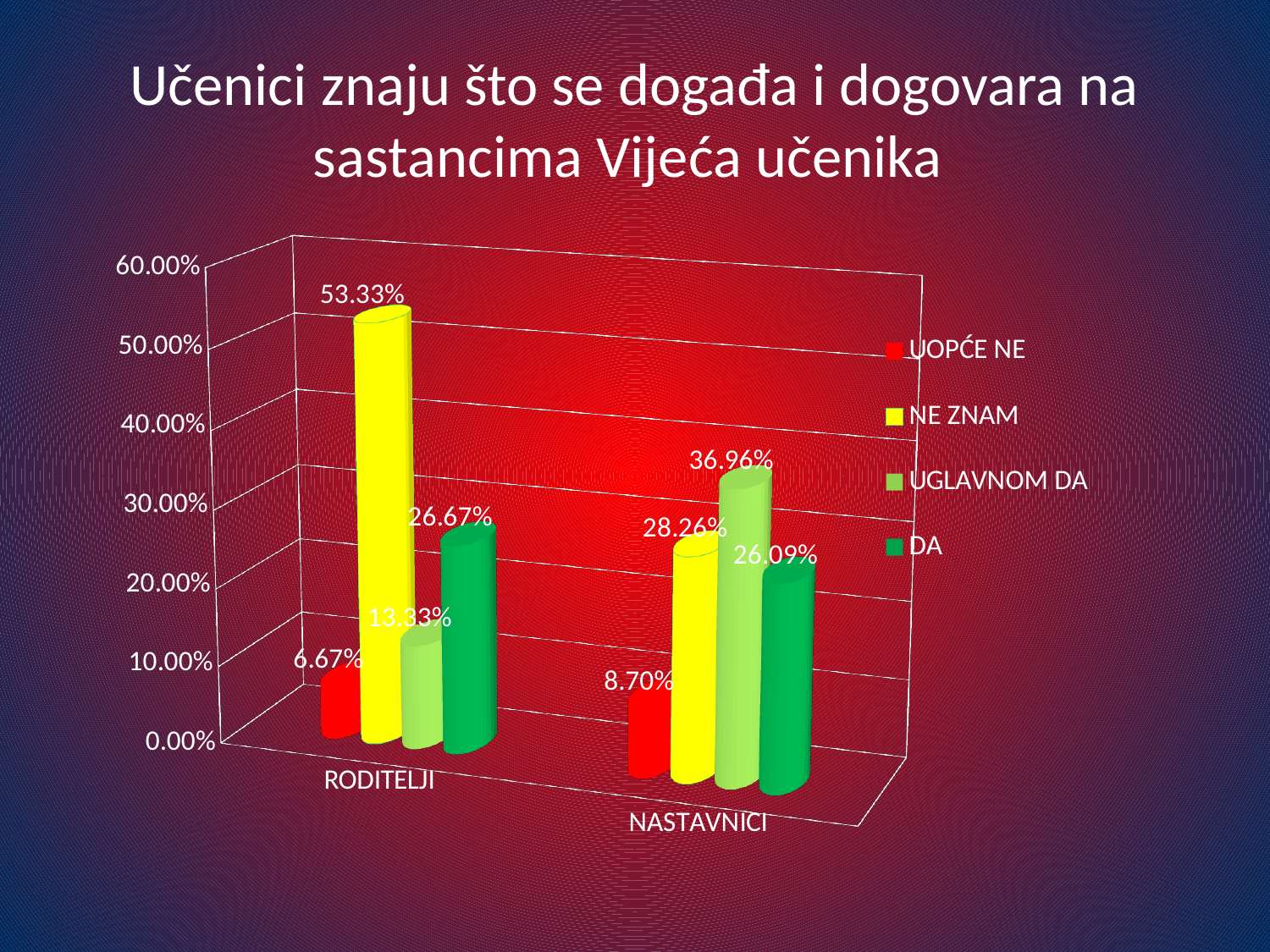
Which series has the highest value in the RODITELJI category? NE ZNAM Which is larger: UGLAVNOM DA for RODITELJI or UGLAVNOM DA for NASTAVNICI? UGLAVNOM DA for NASTAVNICI What is the value for UOPĆE NE in the NASTAVNICI category? 8.70% What colour represents the DA series in the legend? Green What is the value for NE ZNAM in the RODITELJI category? 53.33% How many categories are shown on the x axis? 2 What is the value for UGLAVNOM DA in the NASTAVNICI category? 36.96% What kind of chart is shown on the slide? Bar chart How many series does the legend list? 4 Which series has the lowest value in the NASTAVNICI category? UOPĆE NE What is the value for DA in the RODITELJI category? 26.67% What is the difference between the NE ZNAM values for RODITELJI and NASTAVNICI? 25.07%